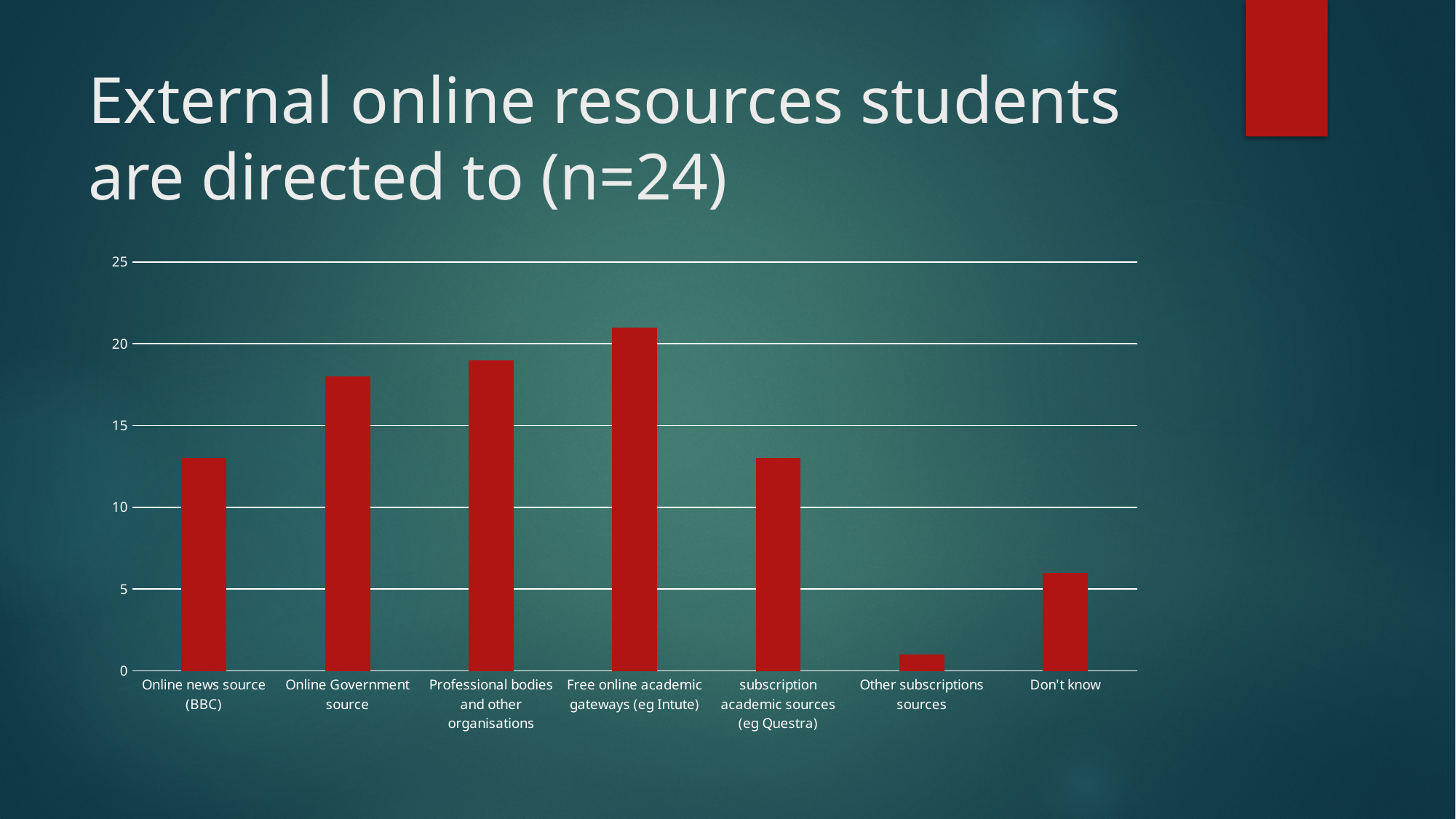
Is the value for Online news source (BBC) greater or less than 10? greater What is the title of the slide containing the chart? External online resources students are directed to (n=24) Which category has the lowest bar in the chart? Other subscriptions sources Is the value for Other subscriptions sources greater or less than 5? less What kind of chart is shown on the slide? bar chart Is the value for Free online academic gateways (eg Intute) greater or less than 20? greater Which is larger, the value for Don't know or the value for Online news source (BBC)? Online news source (BBC) Which category has the highest bar in the chart? Free online academic gateways (eg Intute) What colour are the bars in the chart? red How many categories are shown on the x axis of the chart? 7